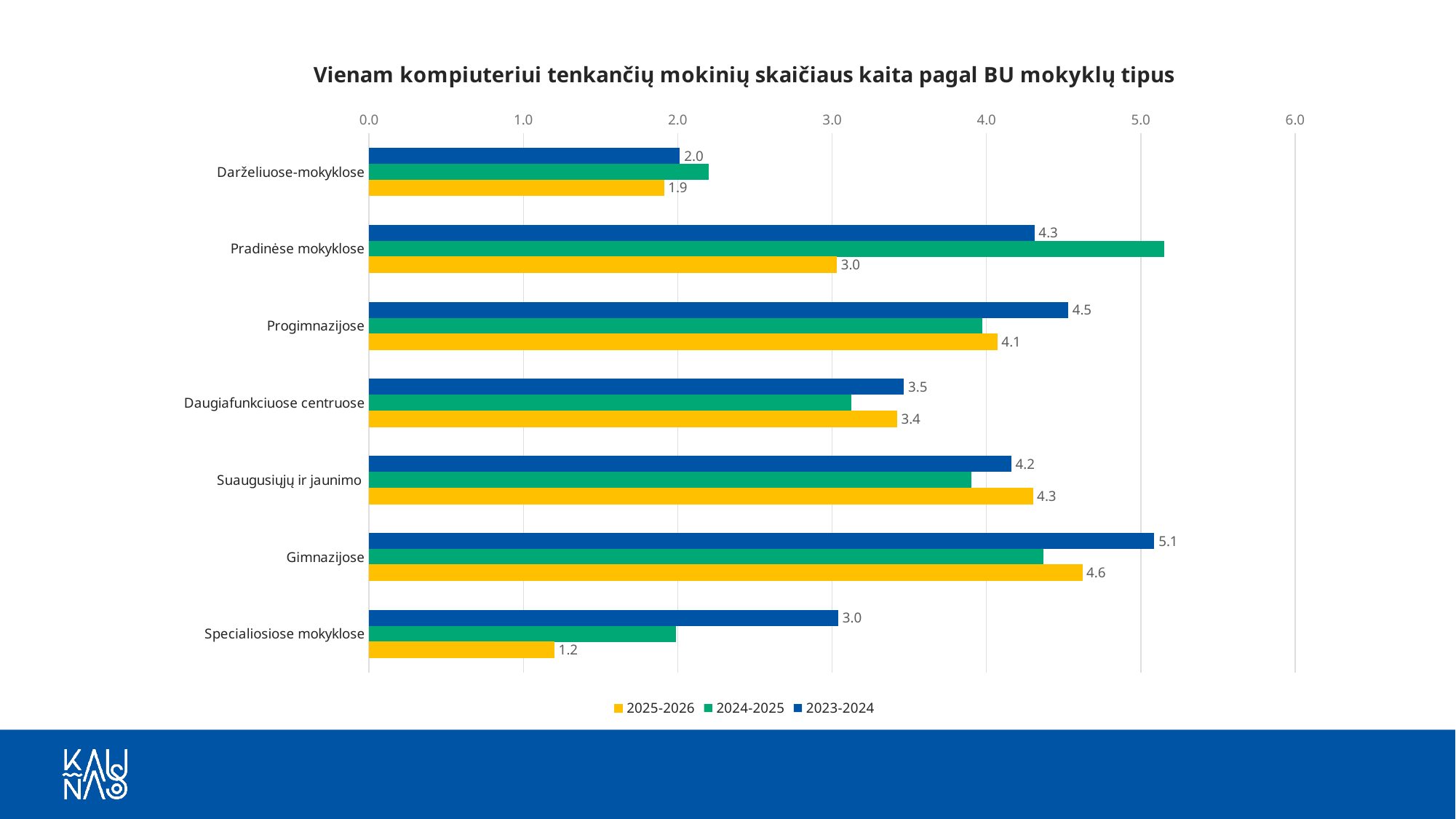
How many school type categories are shown on the chart? 7 What is the value for Gimnazijose in the 2023-2024 series? 5.1 What kind of chart is shown on the slide? Bar chart Which category has the lowest value in the 2025-2026 series? Specialiosiose mokyklose For Specialiosiose mokyklose, which is larger: the 2023-2024 value or the 2025-2026 value? 2023-2024 Which category has the highest value in the 2023-2024 series? Gimnazijose What is the value for Specialiosiose mokyklose in the 2025-2026 series? 1.2 What is the difference between the 2023-2024 and 2025-2026 values for Gimnazijose? 0.5 Is the 2024-2025 value for Specialiosiose mokyklose greater or less than 3.0? less Is the 2024-2025 value for Pradinėse mokyklose greater or less than 5.0? greater What is the value for Pradinėse mokyklose in the 2025-2026 series? 3.0 How many series does the legend list? 3